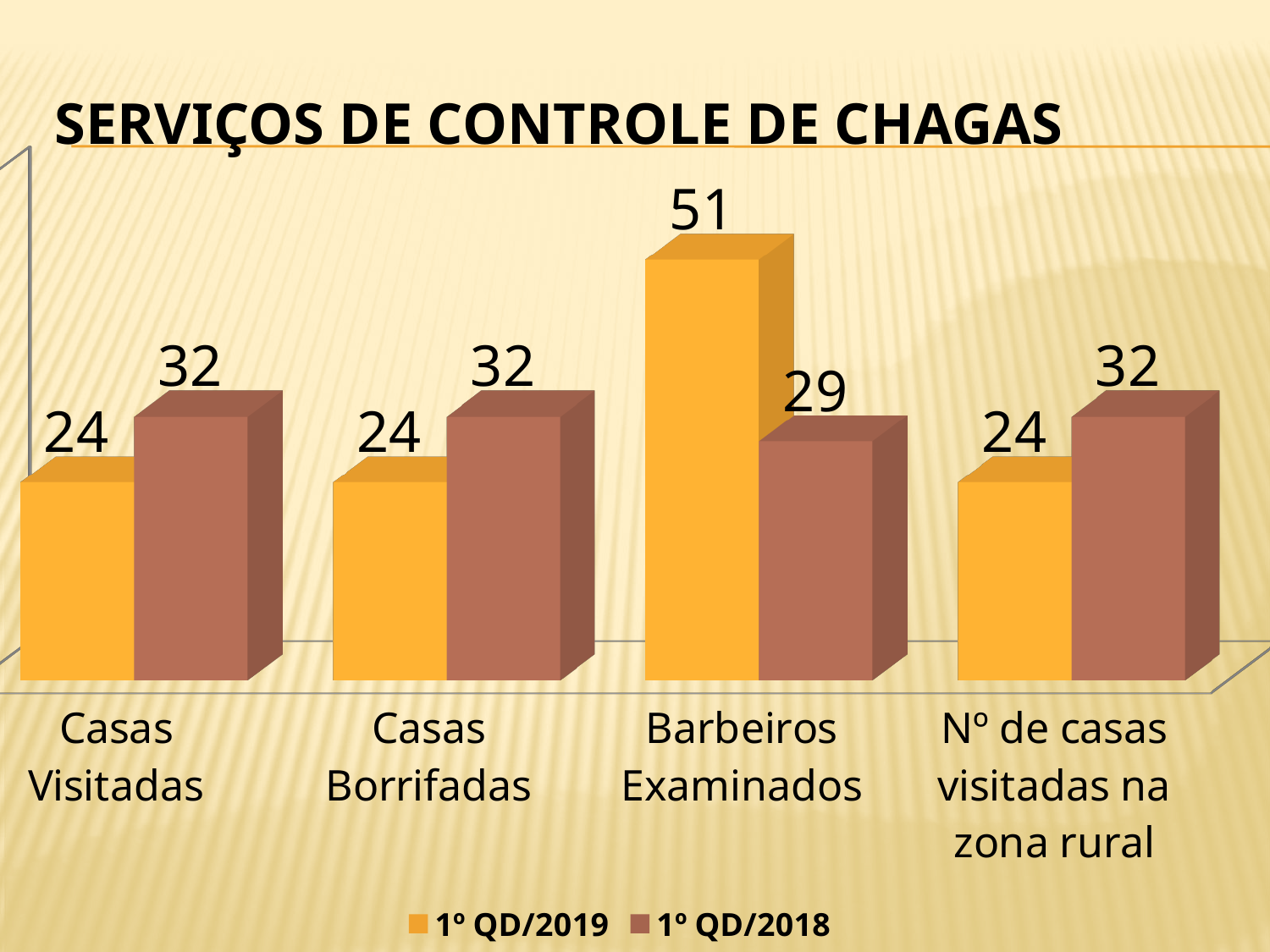
Which is larger for Casas Visitadas: the 1º QD/2019 value or the 1º QD/2018 value? 1º QD/2018 What is the title of the chart? SERVIÇOS DE CONTROLE DE CHAGAS Which category has the lowest value in the 1º QD/2018 series? Barbeiros Examinados Which category has the highest value in the 1º QD/2019 series? Barbeiros Examinados How many series does the legend list? 2 How many categories are shown on the x axis? 4 What is the difference between the 1º QD/2018 and 1º QD/2019 values for Casas Borrifadas? 8 What is the value for Barbeiros Examinados in the 1º QD/2018 series? 29 What is the difference between the 1º QD/2019 and 1º QD/2018 values for Barbeiros Examinados? 22 What kind of chart is shown on the slide? Bar chart What is the value for Casas Visitadas in the 1º QD/2019 series? 24 What is the value for Nº de casas visitadas na zona rural in the 1º QD/2018 series? 32